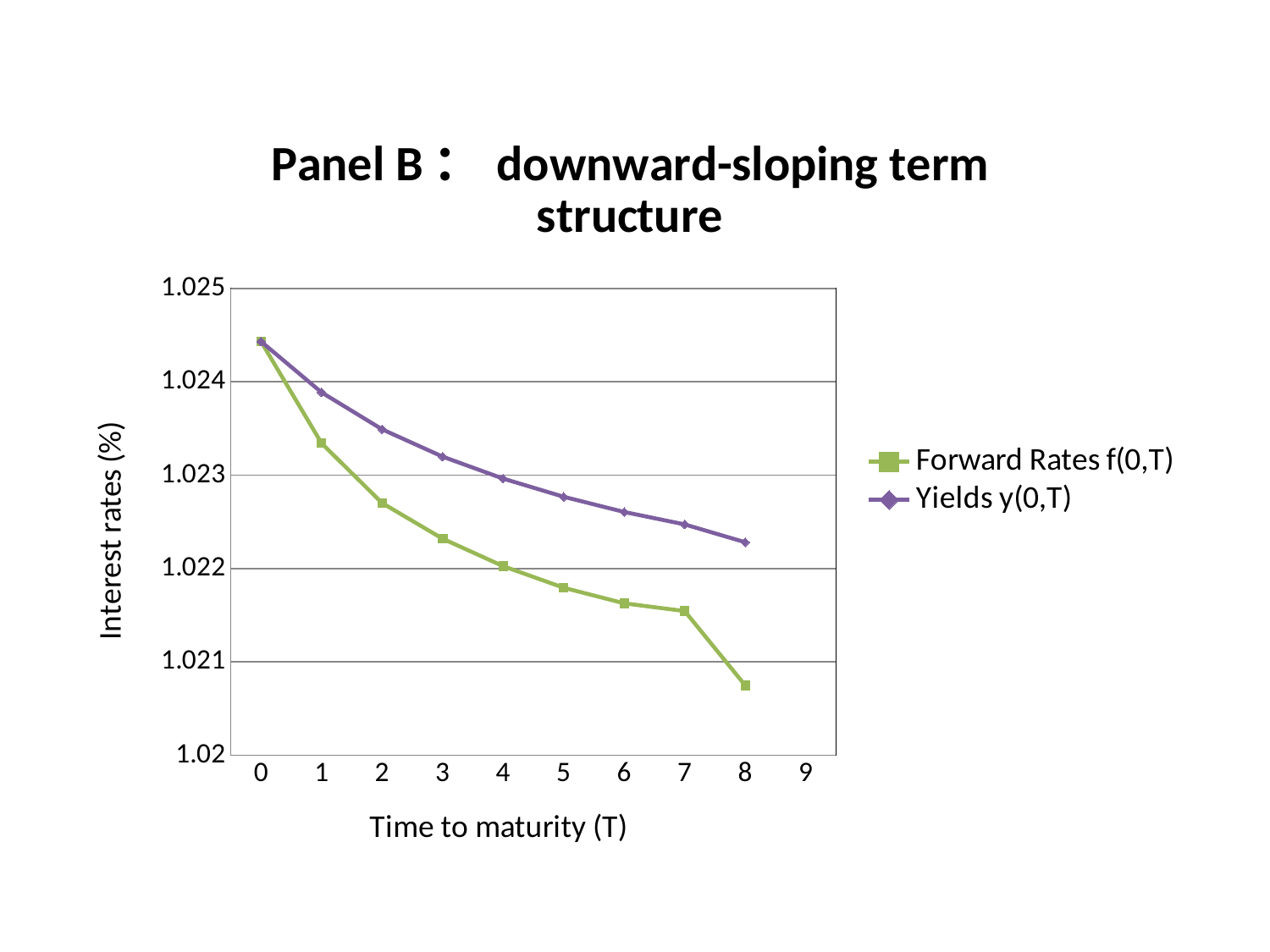
Do the Forward Rates f(0,T) values rise or fall as time to maturity increases? fall Is the Forward Rates f(0,T) value at T = 8 greater or less than 1.021? less Is the Forward Rates f(0,T) value at T = 5 greater or less than 1.022? less Is the Yields y(0,T) value at T = 2 greater or less than 1.023? greater Do the Yields y(0,T) values rise or fall as time to maturity increases? fall How many data points are plotted for the Forward Rates f(0,T) series? 9 At T = 4, which series has the higher value, Forward Rates f(0,T) or Yields y(0,T)? Yields y(0,T) How many series does the legend list? 2 What kind of chart is shown on the slide? line chart At which time to maturity is the Yields y(0,T) value lowest? 8 What is the label of the x axis? Time to maturity (T)